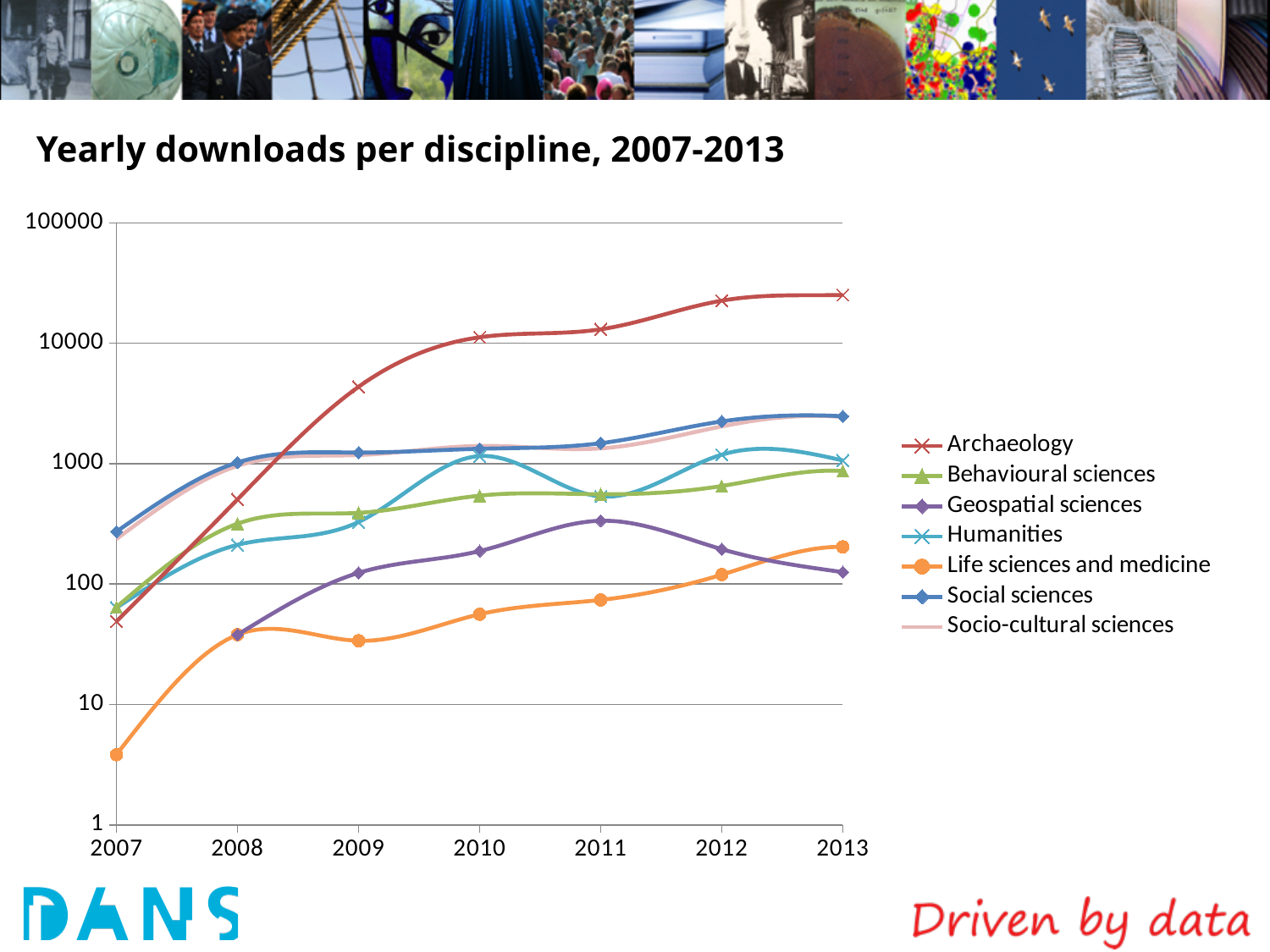
Which is larger in 2007, Social sciences or Archaeology? Social sciences Is the value for Archaeology in 2013 greater or less than 10000? greater How many years are plotted along the x axis? 7 Is the value for Archaeology in 2007 greater or less than 100? less Which discipline has the highest downloads in 2013? Archaeology Is the value for Life sciences and medicine in 2007 greater or less than 10? less How many series does the legend list? 7 What kind of chart is shown on the slide? line chart Do the downloads for Archaeology rise or fall from 2007 to 2013? rise Which discipline has the lowest downloads in 2007? Life sciences and medicine What is the title of the chart? Yearly downloads per discipline, 2007-2013